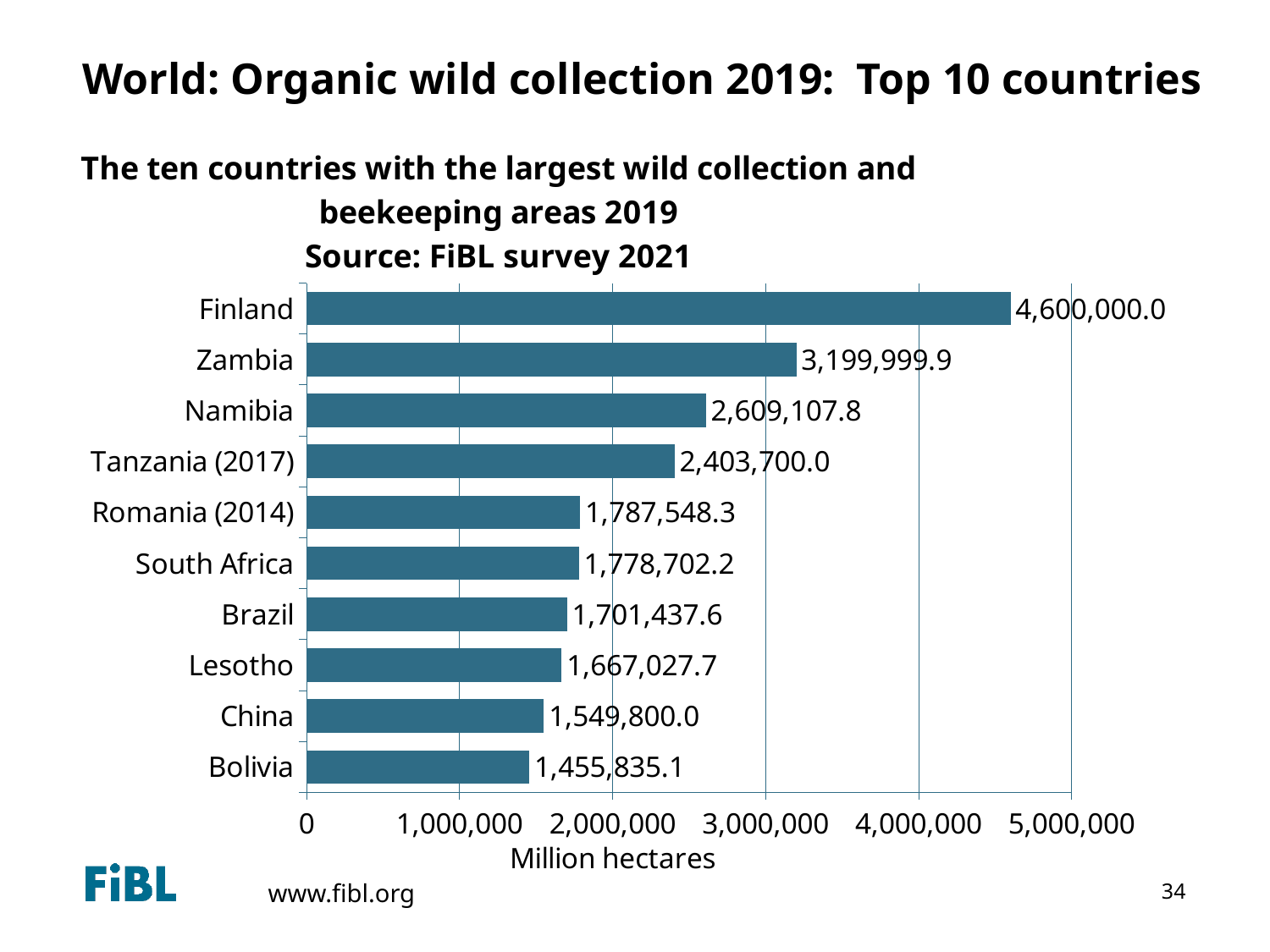
What is the difference between the values for China and Bolivia? 93,964.9 How many countries are shown in the chart? 10 What is the value for Namibia? 2,609,107.8 What is the label on the horizontal axis of the chart? Million hectares Which country has the highest value? Finland Which is larger, the value for Namibia or the value for Tanzania (2017)? Namibia Is the value for Zambia greater or less than 3,000,000? greater What is the value for Finland? 4,600,000.0 Which country has the lowest value? Bolivia What is the difference between the values for Finland and Zambia? 1,400,000.1 What kind of chart is shown on the slide? bar chart What is the value for China? 1,549,800.0